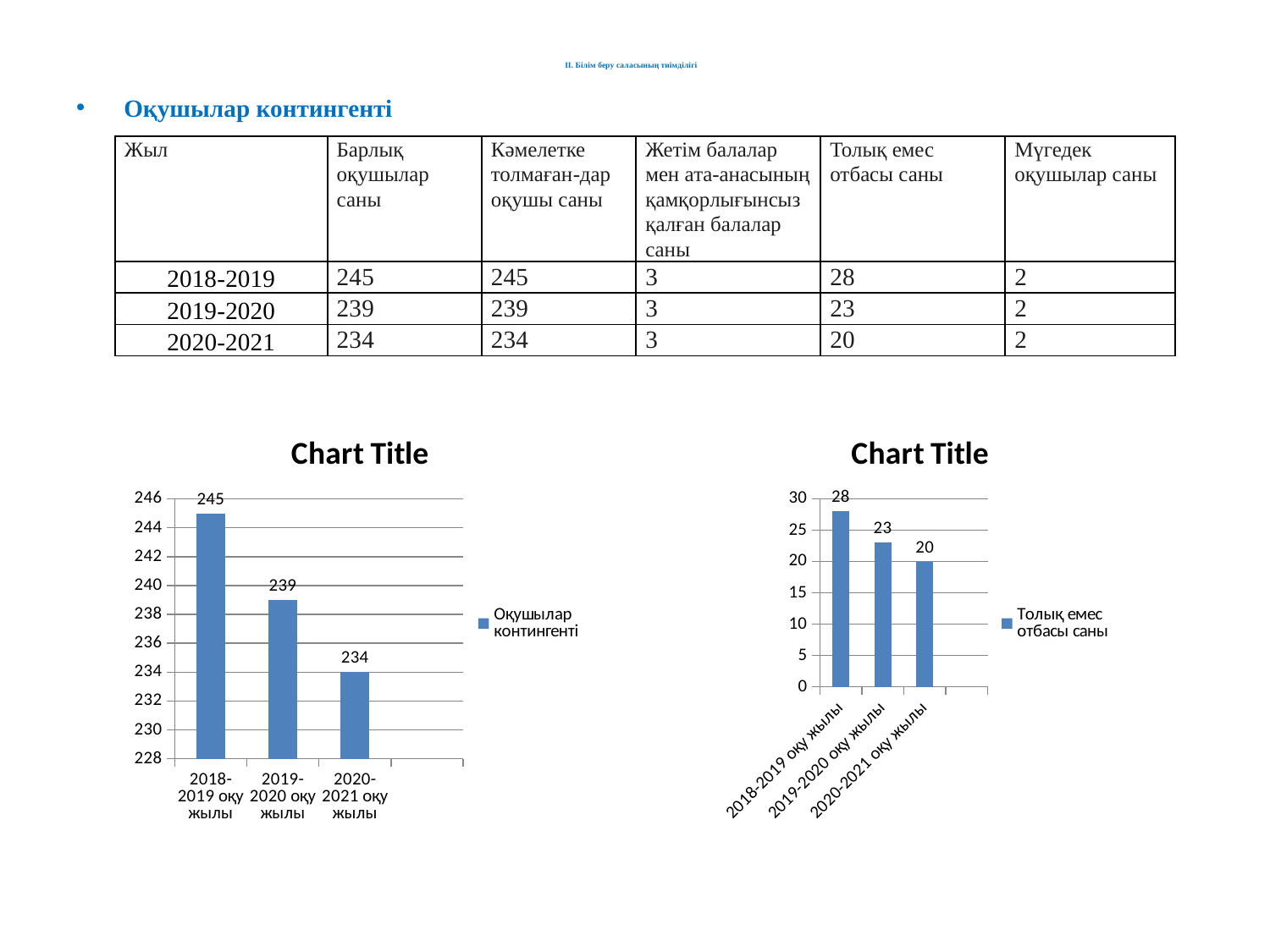
In the left chart, what is the difference between the values for 2018-2019 and 2020-2021? 11 What series name does the legend of the right chart show? Толық емес отбасы саны In the left chart, what is the value for 2018-2019 оқу жылы? 245 In the left chart, what is the value for 2020-2021 оқу жылы? 234 What type of chart is the right chart? bar chart In the right chart, what is the difference between the values for 2018-2019 and 2020-2021? 8 In the right chart, is the value for 2019-2020 оқу жылы larger or smaller than the value for 2020-2021 оқу жылы? larger In the left chart, which year has the lowest value? 2020-2021 оқу жылы In the right chart, which year has the highest value? 2018-2019 оқу жылы In the right chart, what is the value for 2019-2020 оқу жылы? 23 How many bars does the left chart have? 3 In the left chart, do the values rise or fall from 2018-2019 to 2020-2021? fall